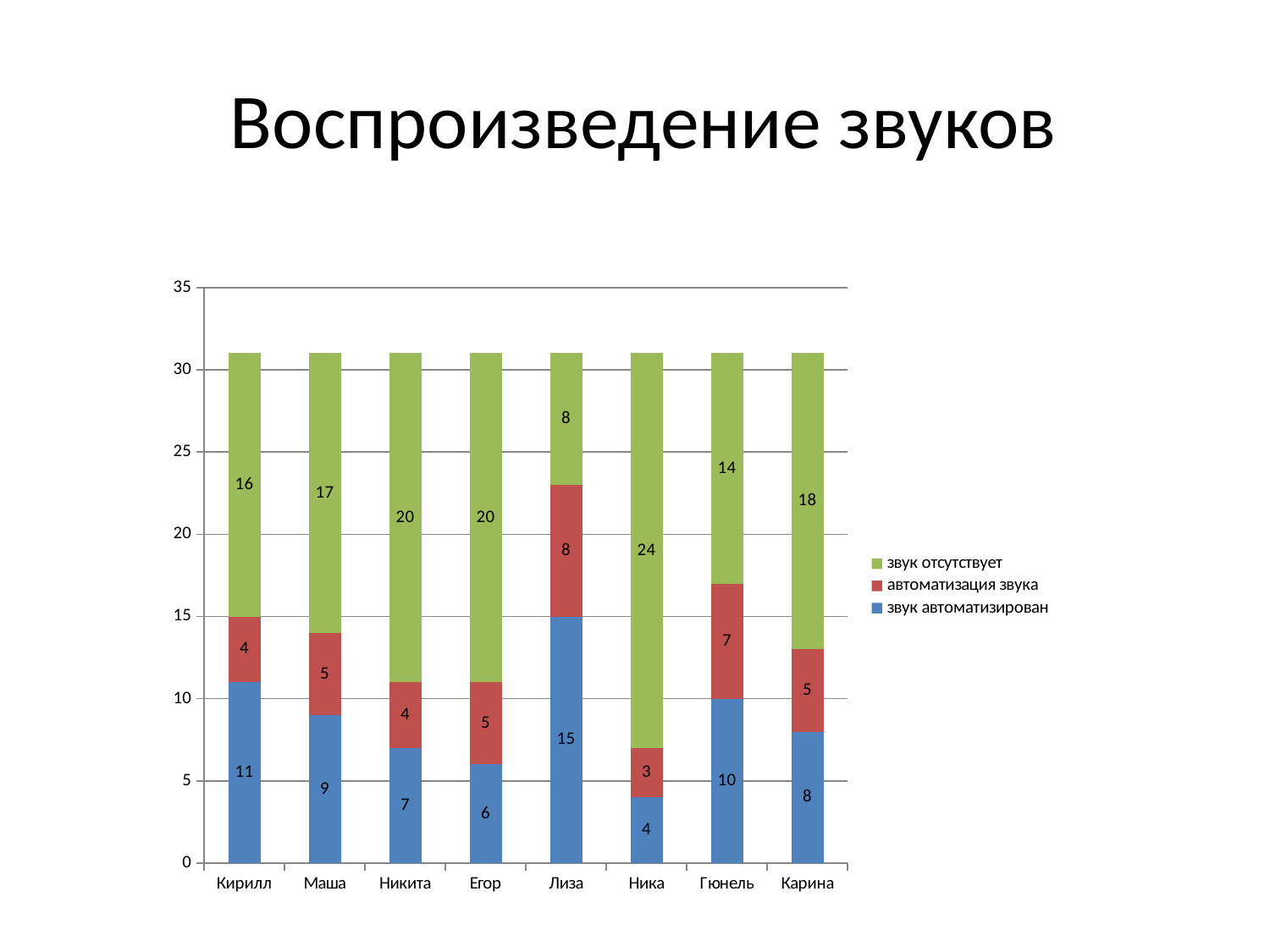
Which category has the lowest value for "звук отсутствует"? Лиза What is the value of "звук автоматизирован" for Лиза? 15 What is the total of the stacked bar for Кирилл? 31 What kind of chart is shown on the slide? stacked bar chart What is the value of "автоматизация звука" for Гюнель? 7 What is the value of "звук отсутствует" for Ника? 24 What is the title of the slide? Воспроизведение звуков Which category has the highest value for "звук автоматизирован"? Лиза How many series does the legend list? 3 What is the difference between the "звук отсутствует" values for Ника and Гюнель? 10 Which is larger: the "звук автоматизирован" value for Маша or for Карина? Маша How many categories (names) are shown on the x axis? 8